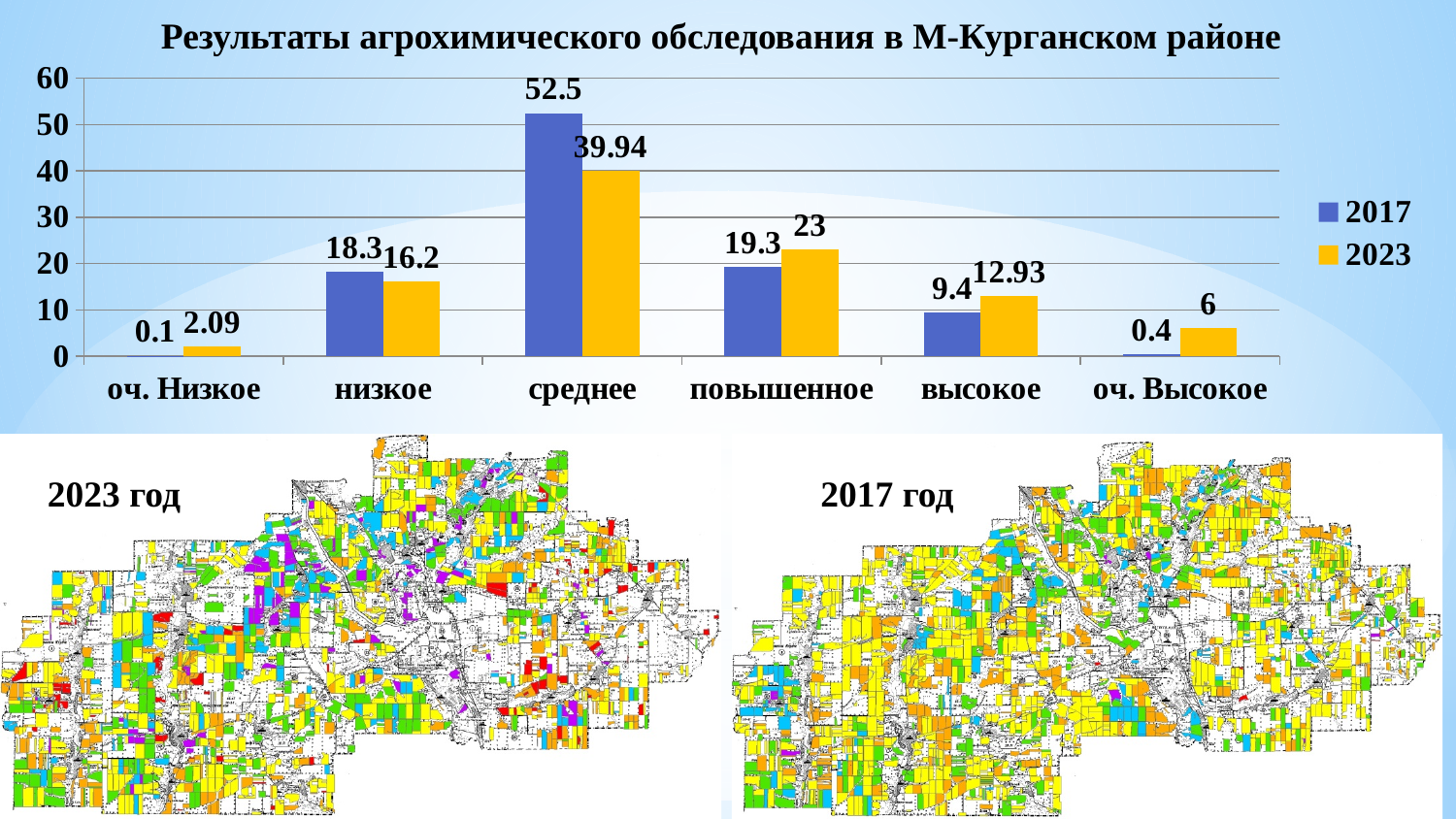
What is the 2023 value for the "оч. Высокое" category? 6 What type of chart is shown on the slide? bar chart How many series does the chart legend list? 2 What is the difference between the 2017 and 2023 values for "среднее"? 12.56 What is the 2017 value for the "повышенное" category? 19.3 What is the title of the chart? Результаты агрохимического обследования в М-Курганском районе Which category has the lowest 2023 value? оч. Низкое What is the 2023 value for the "среднее" category? 39.94 For the "высокое" category, which year has the larger value, 2017 or 2023? 2023 Which category has the highest 2017 value? среднее Is the 2017 value for "низкое" greater or less than 20? less How many categories are shown on the x axis of the chart? 6